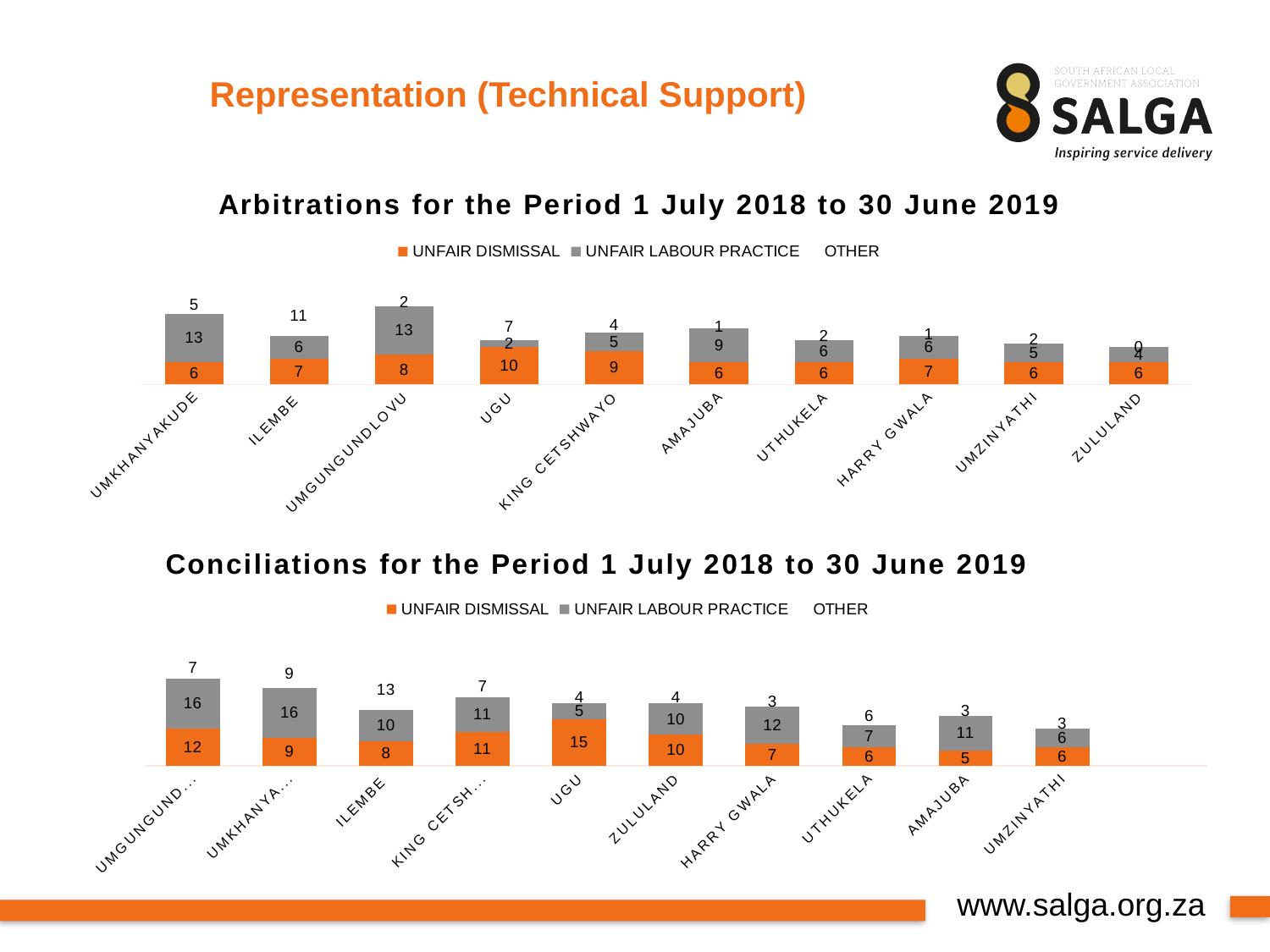
In the Arbitrations chart, what is the total of the stacked bar for ZULULAND? 10 In the Arbitrations chart, what is the UNFAIR DISMISSAL value for UGU? 10 How many series does the legend of the Arbitrations chart list? 3 In the Conciliations chart, what is the total of the stacked bar for UMZINYATHI? 15 In the Conciliations chart, which has the larger UNFAIR DISMISSAL value, ZULULAND or HARRY GWALA? ZULULAND In the Conciliations chart, what is the UNFAIR DISMISSAL value for UGU? 15 In the Arbitrations chart, what is the OTHER value for ILEMBE? 11 In the Conciliations chart, what is the OTHER value for ILEMBE? 13 In the Arbitrations chart, what is the UNFAIR LABOUR PRACTICE value for UMKHANYAKUDE? 13 How many categories are shown on the x axis of the Arbitrations chart? 10 In the Conciliations chart, what is the difference between the UNFAIR LABOUR PRACTICE values for HARRY GWALA and AMAJUBA? 1 In the Arbitrations chart, which category has the highest UNFAIR DISMISSAL value? UGU